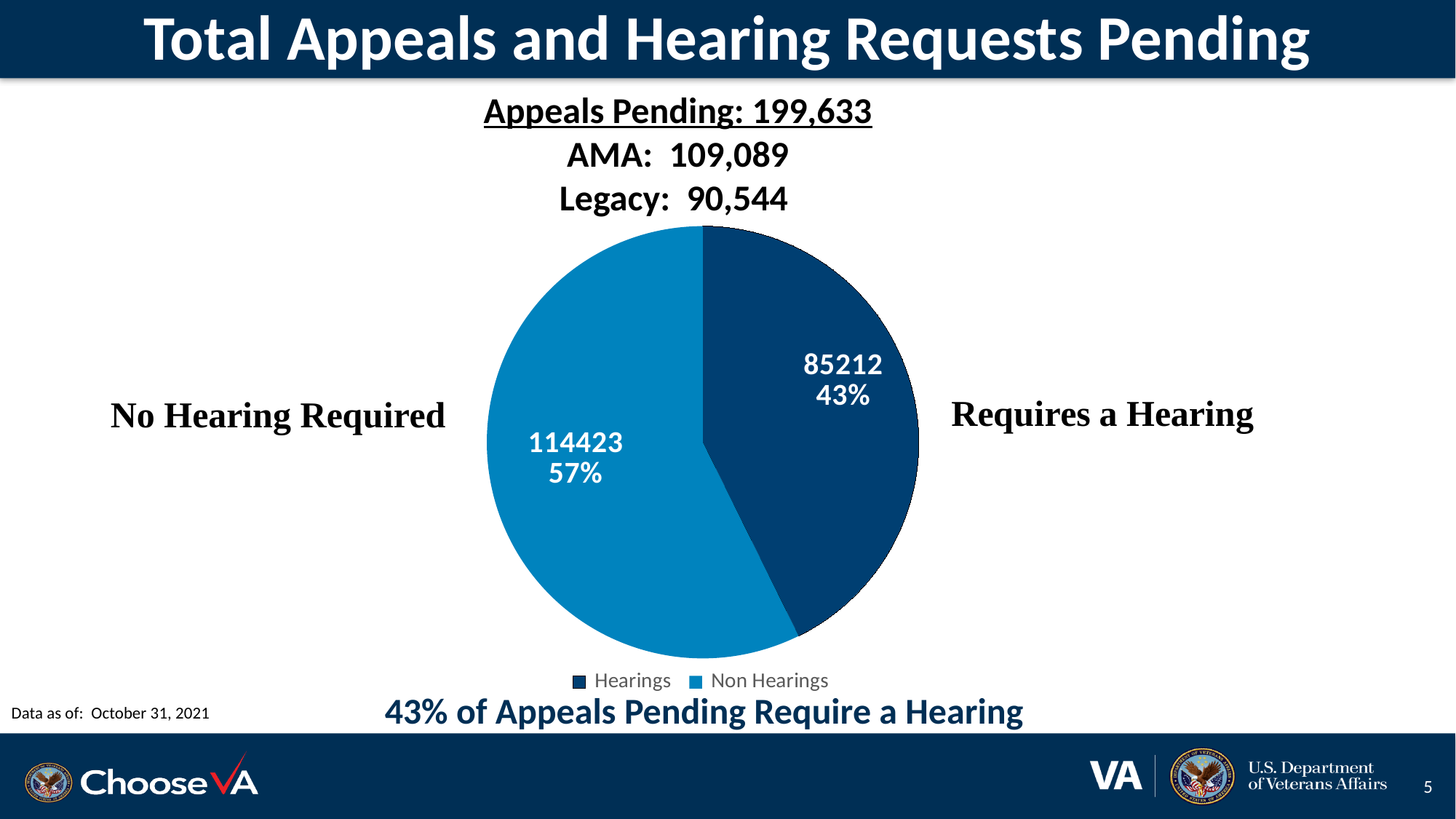
Which slice of the pie chart is the largest? Non Hearings What is the title of the slide containing the pie chart? Total Appeals and Hearing Requests Pending What is the value for Hearings in the pie chart? 85212 How many slices does the pie chart have? 2 Which is larger, the Hearings slice or the Non Hearings slice? Non Hearings What is the value for Non Hearings in the pie chart? 114423 What share of the pie does the Hearings slice represent? 43% What type of chart is shown on the slide? pie chart What is the difference between the Non Hearings value and the Hearings value? 29211 How many entries does the legend list? 2 Which slice of the pie chart is the smallest? Hearings What share of the pie does the Non Hearings slice represent? 57%